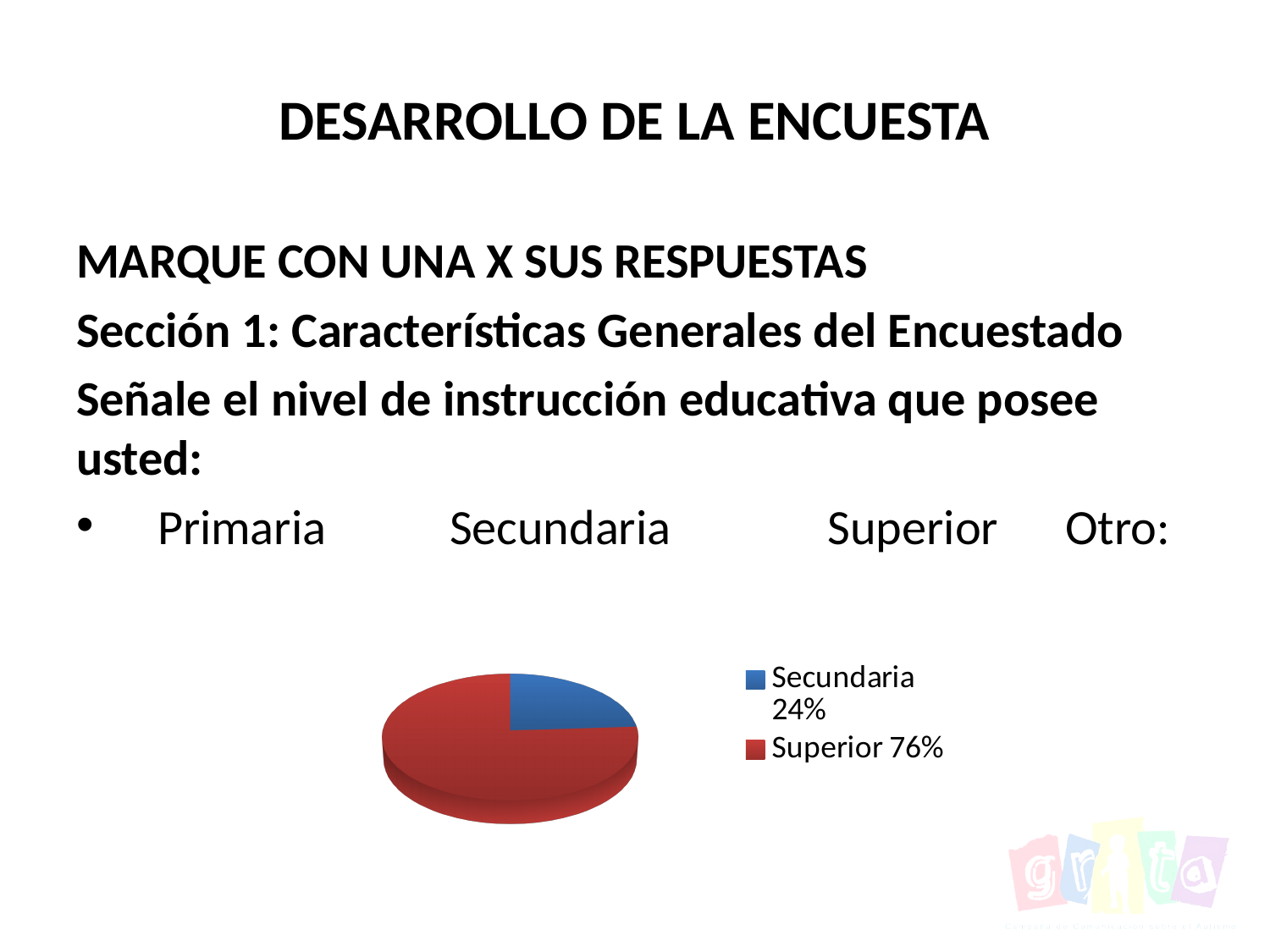
What is the difference in percentage points between Superior and Secundaria in the pie chart? 52 What percentage of the pie chart corresponds to Superior? 76% What is the combined share of Secundaria and Superior in the pie chart? 100% How many slices does the pie chart have? 2 How many entries does the legend of the pie chart list? 2 What kind of chart is shown on the slide? pie chart Which is larger in the pie chart, Secundaria or Superior? Superior What percentage of the pie chart corresponds to Secundaria? 24% What colour is the Superior slice in the pie chart? red What colour is the Secundaria slice in the pie chart? blue Which category has the largest share of the pie chart? Superior Which category has the smallest share of the pie chart? Secundaria